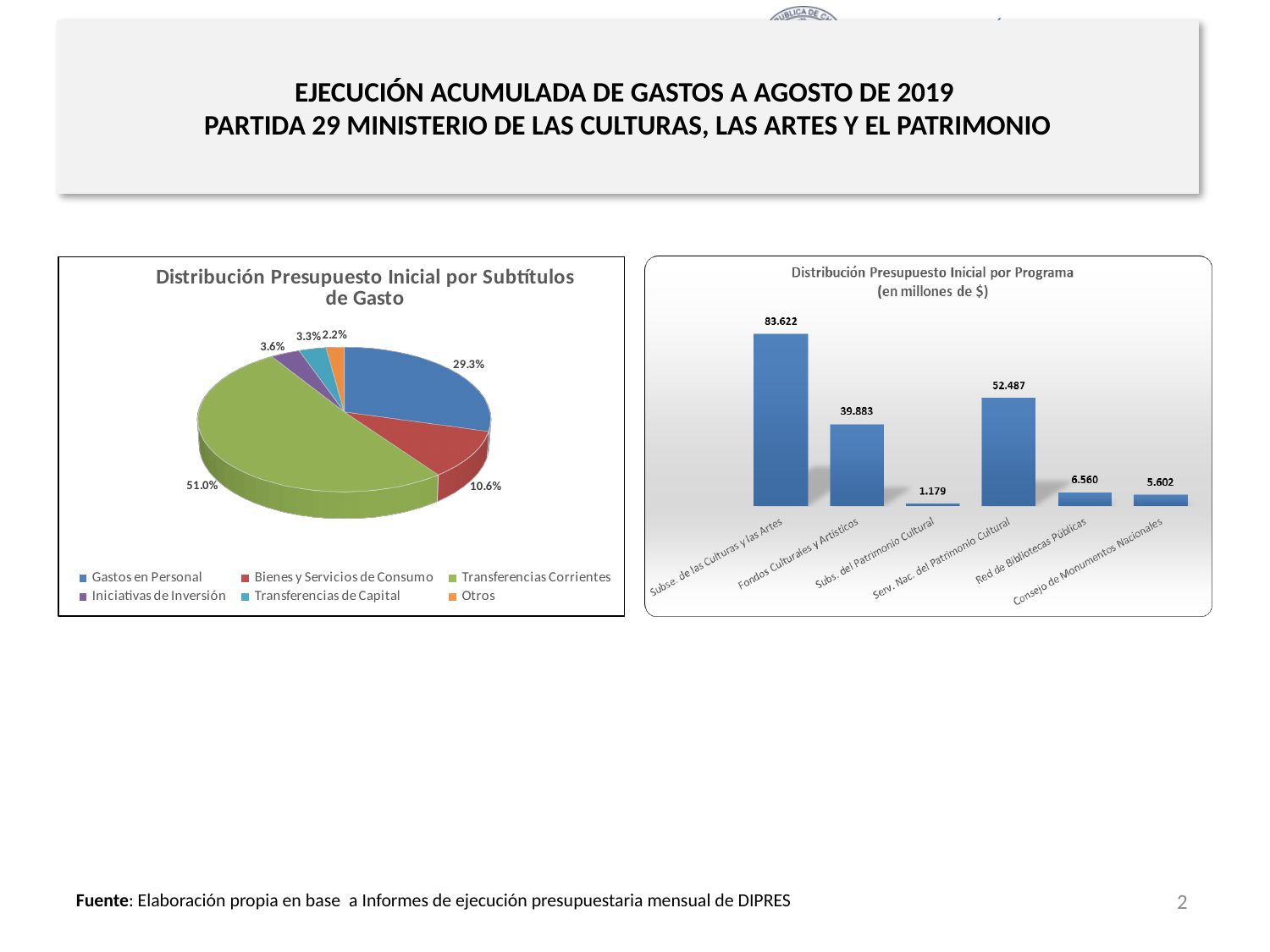
What kind of chart is 'Distribución Presupuesto Inicial por Subtítulos de Gasto'? Pie chart In the 'Distribución Presupuesto Inicial por Programa' chart, what is the value for Serv. Nac. del Patrimonio Cultural? 52.487 In the 'Distribución Presupuesto Inicial por Subtítulos de Gasto' chart, what share does Transferencias Corrientes have? 51.0% How many bars are in the 'Distribución Presupuesto Inicial por Programa' chart? 6 In the 'Distribución Presupuesto Inicial por Programa' chart, which program has the highest value? Subse. de las Culturas y las Artes In the 'Distribución Presupuesto Inicial por Programa' chart, what is the value for Subs. del Patrimonio Cultural? 1.179 In the 'Distribución Presupuesto Inicial por Subtítulos de Gasto' chart, how many categories does the legend list? 6 In the 'Distribución Presupuesto Inicial por Programa' chart, which is larger: Red de Bibliotecas Públicas or Consejo de Monumentos Nacionales? Red de Bibliotecas Públicas In the 'Distribución Presupuesto Inicial por Subtítulos de Gasto' chart, which category has the smallest slice? Otros In the 'Distribución Presupuesto Inicial por Programa' chart, what is the difference between Subse. de las Culturas y las Artes and Serv. Nac. del Patrimonio Cultural? 31.135 In the 'Distribución Presupuesto Inicial por Subtítulos de Gasto' chart, what share does Gastos en Personal have? 29.3% What kind of chart is 'Distribución Presupuesto Inicial por Programa'? Bar chart